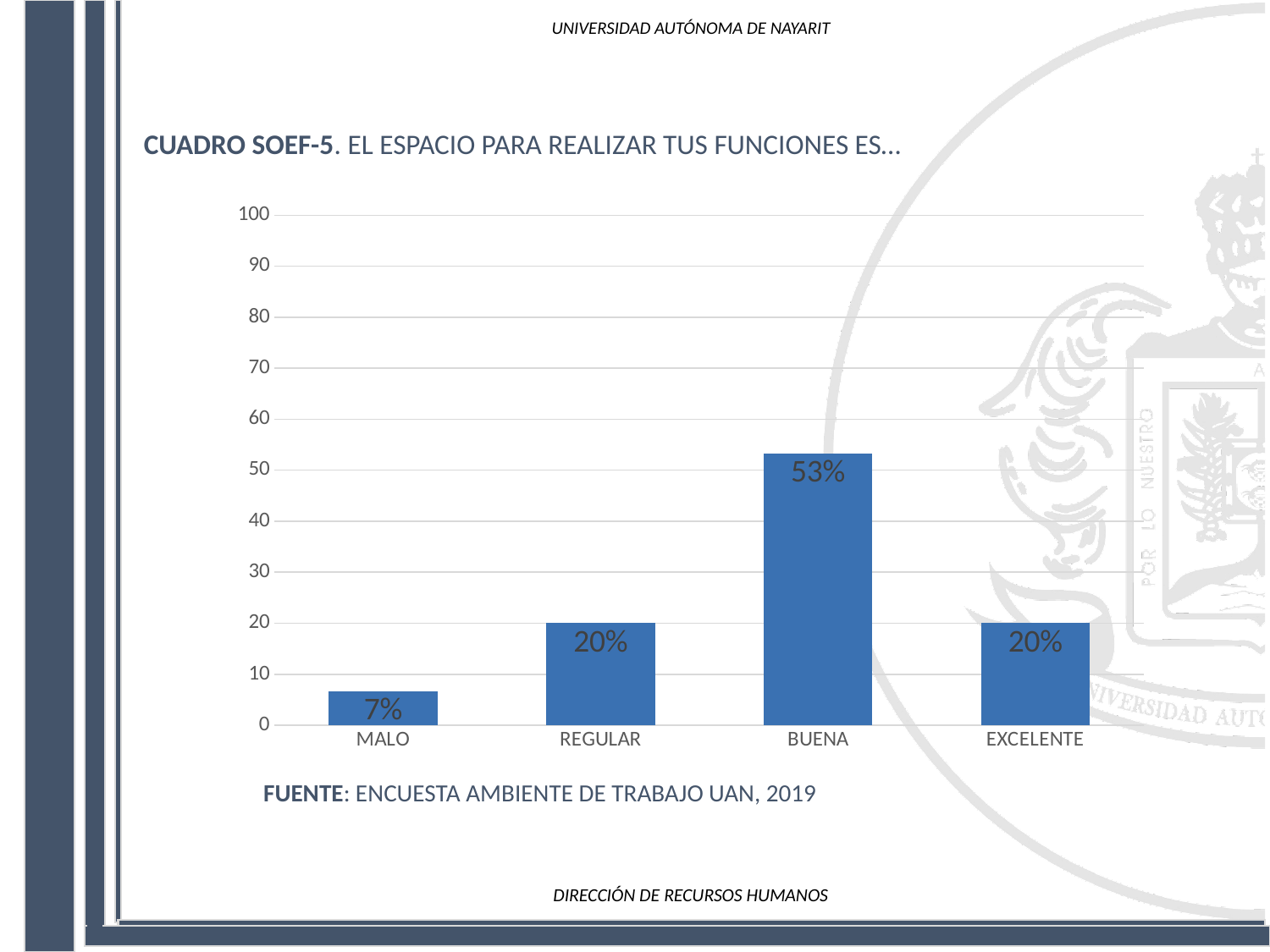
Which category has the highest value? BUENA Is the value for BUENA greater or less than 50? greater Which category has the lowest value? MALO What is the value for EXCELENTE? 20% What is the value for BUENA? 53% How many categories are shown on the x axis? 4 What kind of chart is shown on the slide? bar chart Which is larger, the value for BUENA or the value for EXCELENTE? BUENA What is the difference between the values for EXCELENTE and MALO? 13% What is the value for MALO? 7% What is the value for REGULAR? 20% What is the difference between the values for BUENA and REGULAR? 33%